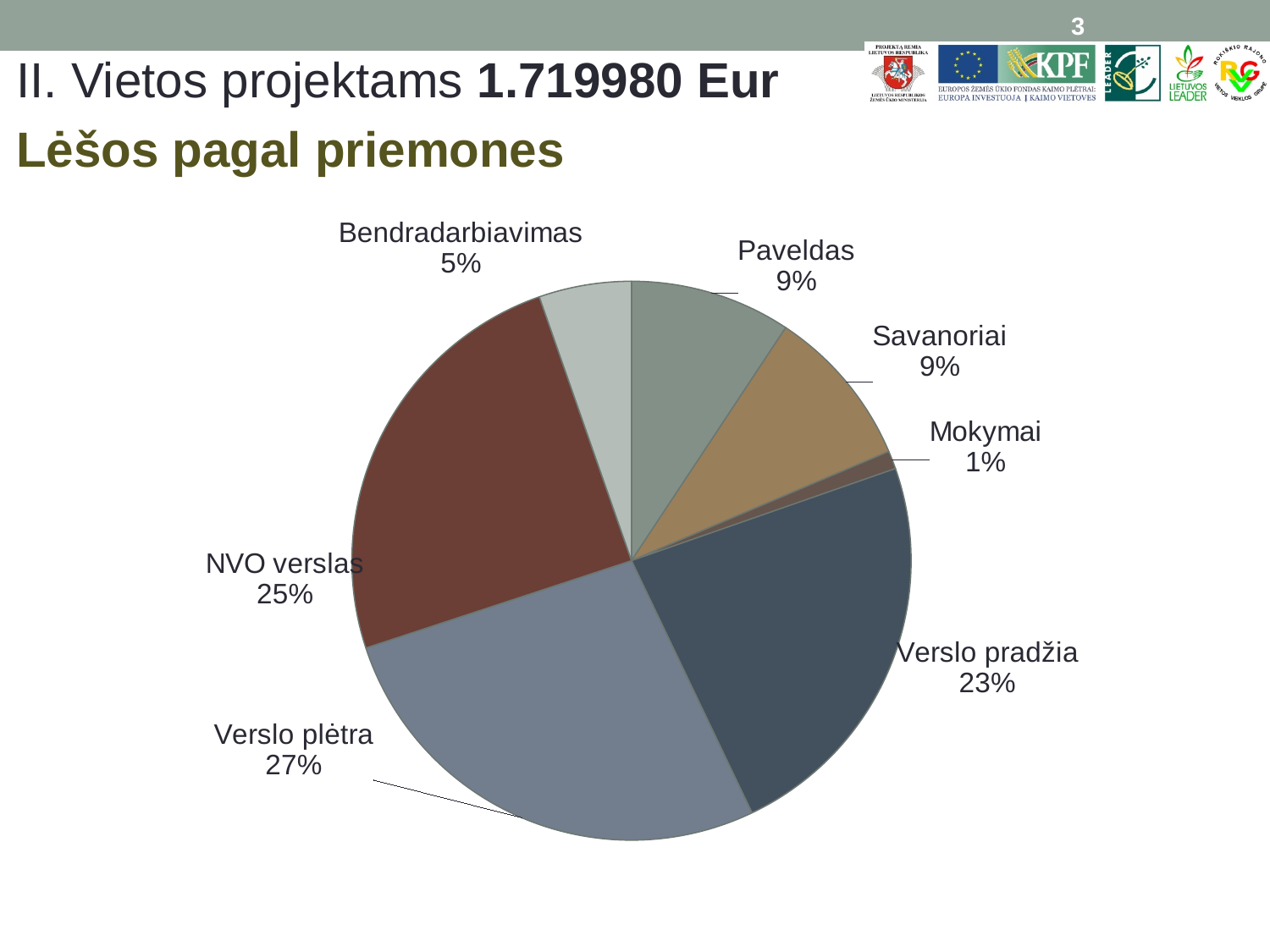
What share of the pie does Bendradarbiavimas have? 5% What share of the pie does Mokymai have? 1% What type of chart is shown on the slide? pie chart What is the difference in percentage points between Verslo plėtra and Verslo pradžia? 4 What is the title of the chart? Lėšos pagal priemones Which category has the largest share of the pie? Verslo plėtra Which is larger, the share for NVO verslas or the share for Paveldas? NVO verslas What share of the pie does Verslo plėtra have? 27% How many slices does the pie chart have? 7 Which category has the smallest share of the pie? Mokymai